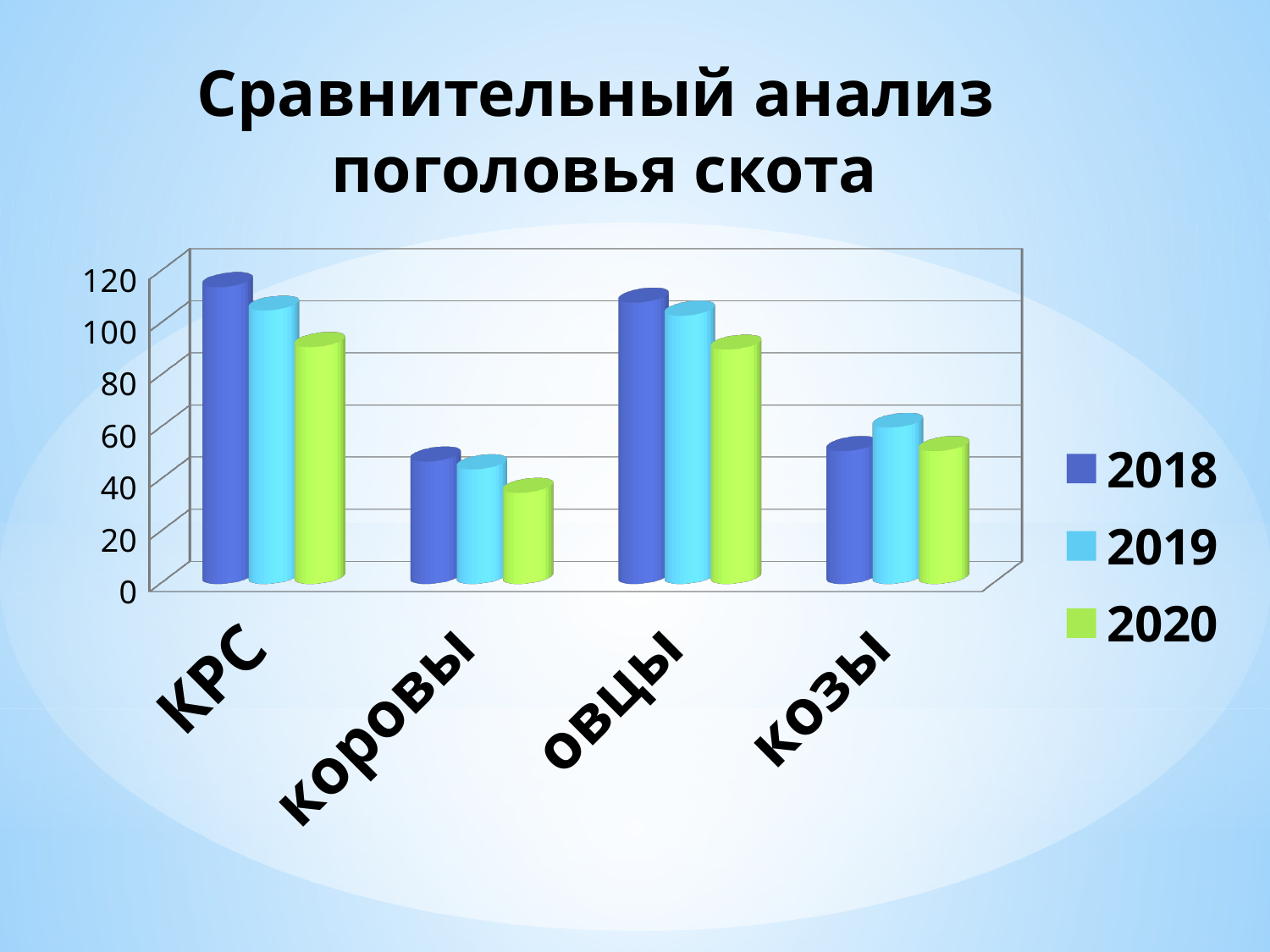
What is the title of the chart? Сравнительный анализ поголовья скота Which years are listed in the legend? 2018, 2019, 2020 Do the values for КРС rise or fall from 2018 to 2020? fall Is the value for козы in 2019 greater or less than 80? less How many series does the legend list? 3 Is the value for овцы in 2019 greater or less than 80? greater Is the value for КРС in 2018 greater or less than 100? greater Which is larger for 2018: the value for КРС or the value for коровы? КРС What kind of chart is shown on the slide? bar chart Which category has the lowest value for 2019? коровы How many categories are shown on the x axis of the chart? 4